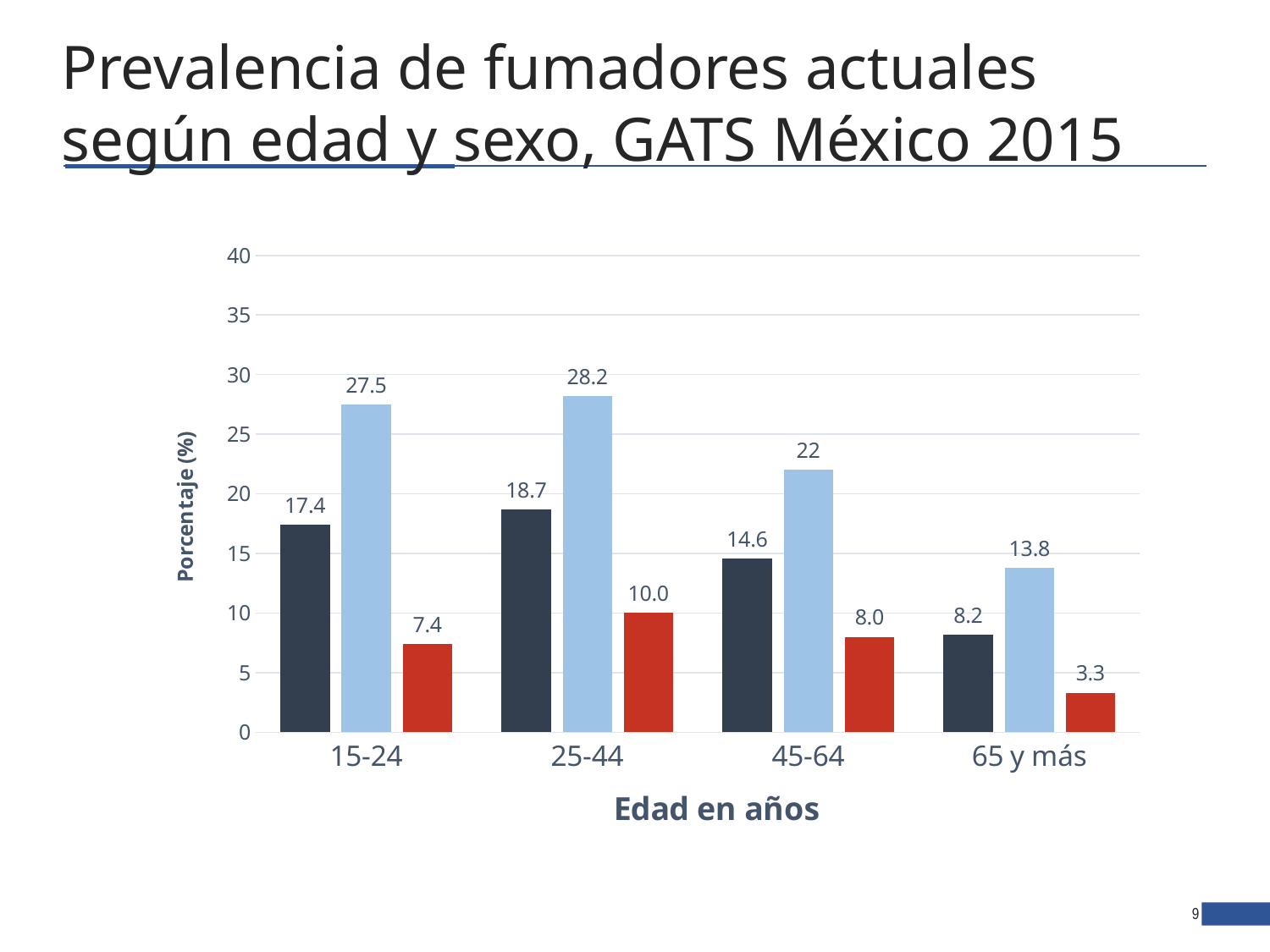
Which age group has the highest light blue bar? 25-44 What is the value of the light blue bar for the 25-44 age group? 28.2 What is the difference between the light blue bar and the red bar for the 15-24 age group? 20.1 What is the label of the y axis? Porcentaje (%) What is the value of the red bar for the 65 y más age group? 3.3 Which age group has the lowest dark blue bar? 65 y más How many age groups are shown on the x axis? 4 Do the red bars rise or fall from the 25-44 age group to the 65 y más age group? fall Which is larger for the 45-64 age group: the dark blue bar or the red bar? the dark blue bar What is the value of the dark blue bar for the 45-64 age group? 14.6 Is the value of the light blue bar for the 45-64 age group greater or less than 20? greater What kind of chart is shown on the slide? bar chart